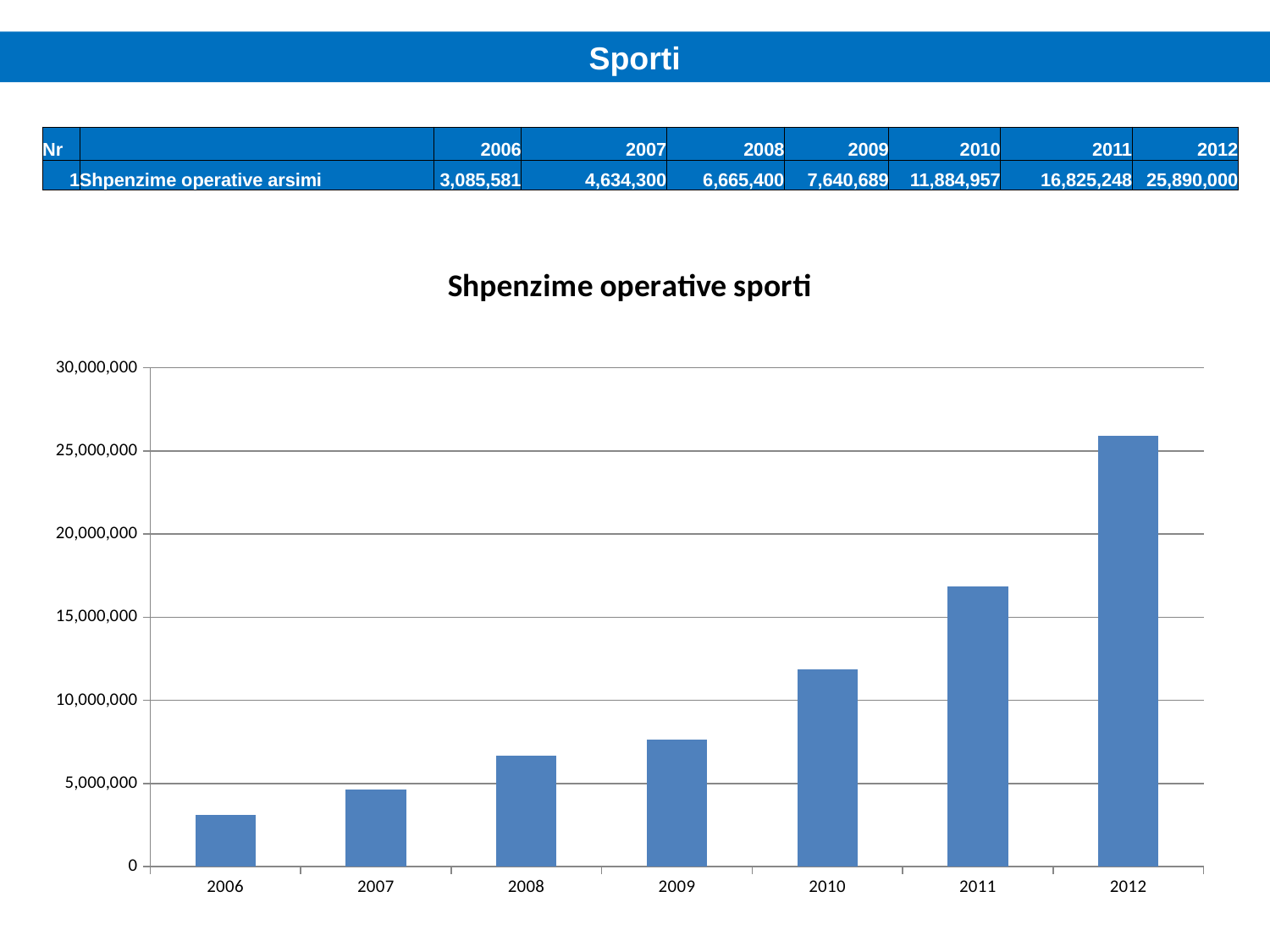
What type of chart is shown on the slide? bar chart Is the value for 2012 greater or less than 25,000,000? greater Which year has the lowest value in the chart? 2006 Which year has the highest value in the chart? 2012 Is the value for 2008 greater or less than 5,000,000? greater What is the title of the chart? Shpenzime operative sporti According to the table on the slide, what is the value for 2010? 11,884,957 Do the values rise or fall from 2006 to 2012? rise Using the values in the table, what is the difference between 2012 and 2006? 22,804,419 Is the value for 2010 greater or less than 10,000,000? greater How many years are shown on the x axis of the chart? 7 Which is larger, the value for 2009 or the value for 2011? 2011